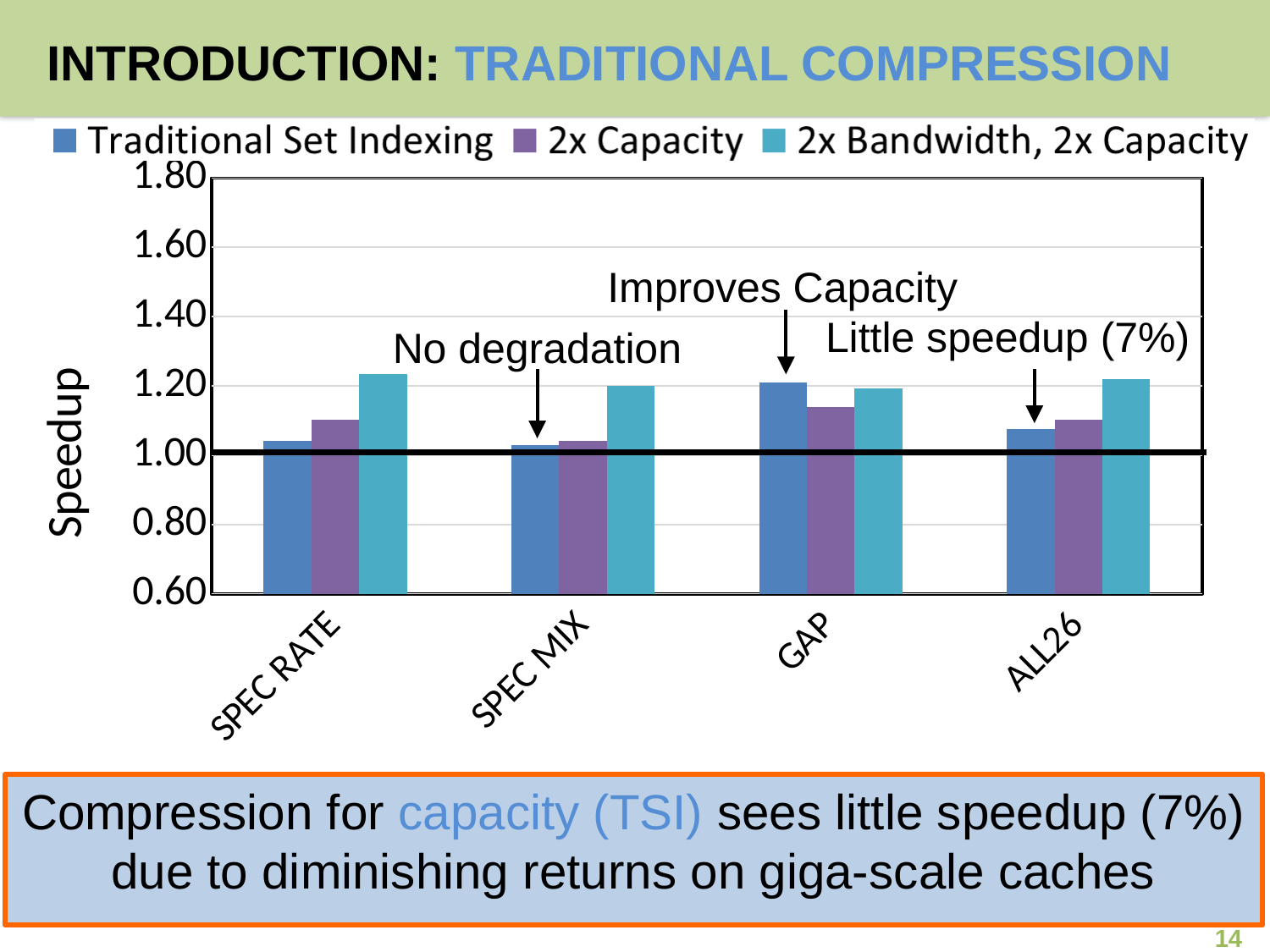
For SPEC RATE, which is larger: Traditional Set Indexing or 2x Bandwidth, 2x Capacity? 2x Bandwidth, 2x Capacity Is the Traditional Set Indexing value for ALL26 greater or less than 1.20? less Which series is shown in the lightest blue (teal) colour in the legend? 2x Bandwidth, 2x Capacity How many series does the legend list? 3 How many categories are shown on the x axis? 4 Is the Traditional Set Indexing value for SPEC MIX greater or less than 1.00? greater For GAP, which is larger: Traditional Set Indexing or 2x Capacity? Traditional Set Indexing Which category has the highest Traditional Set Indexing speedup? GAP What is the label on the y axis of the chart? Speedup Is the 2x Capacity value for GAP greater or less than 1.20? less Is the Traditional Set Indexing value for GAP larger than the Traditional Set Indexing value for SPEC MIX? yes What kind of chart is shown on the slide? bar chart